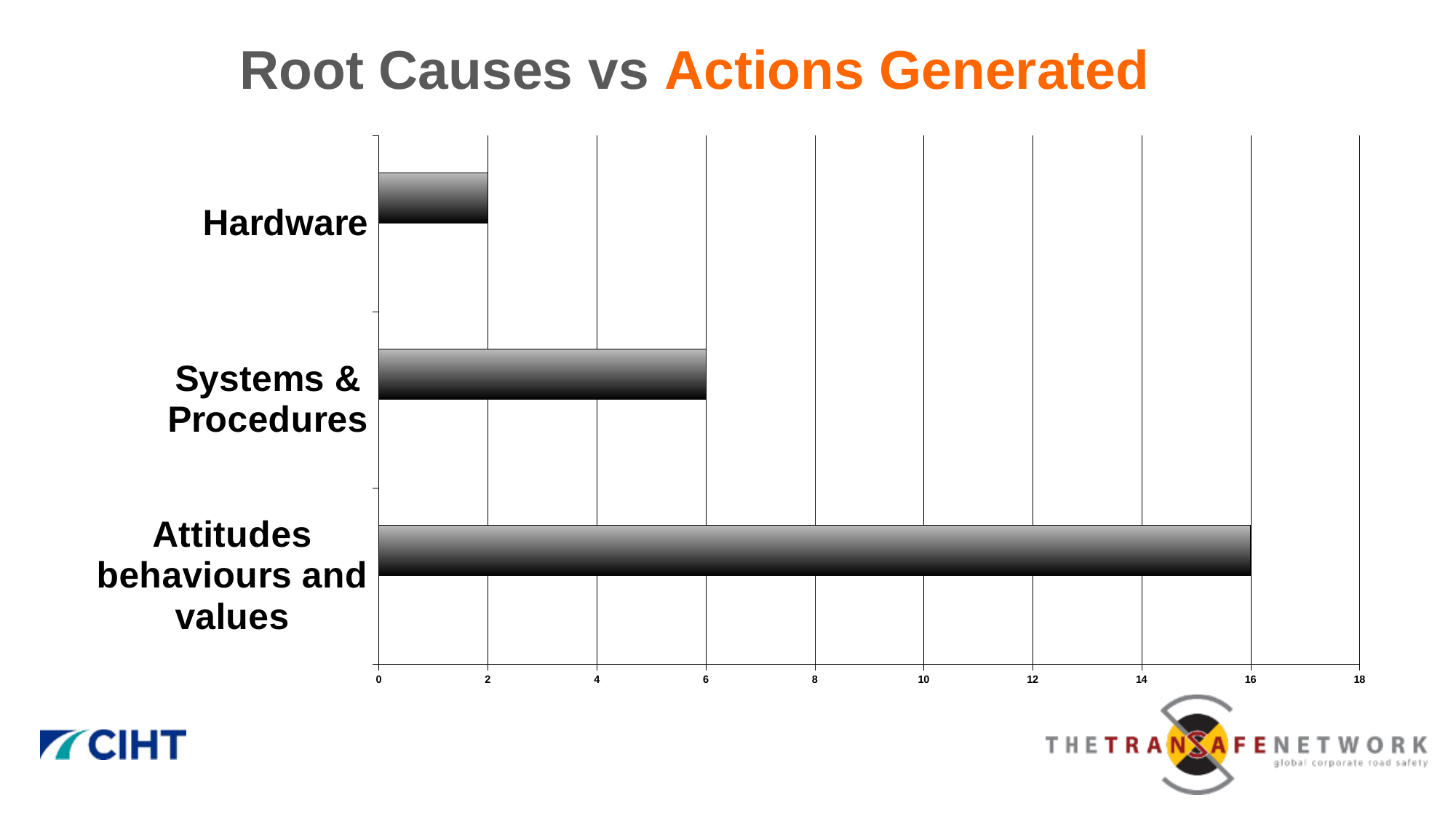
What is the value for Hardware? 2 What is the value for Systems & Procedures? 6 What kind of chart is shown on the slide? bar chart What is the value for Attitudes behaviours and values? 16 Which is larger, the value for Hardware or the value for Systems & Procedures? Systems & Procedures What is the difference between the values for Systems & Procedures and Hardware? 4 Which category has the lowest value? Hardware How many categories are shown in the chart? 3 What is the title of the slide? Root Causes vs Actions Generated Which category has the highest value? Attitudes behaviours and values Is the value for Attitudes behaviours and values greater or less than 10? greater What is the difference between the values for Attitudes behaviours and values and Systems & Procedures? 10